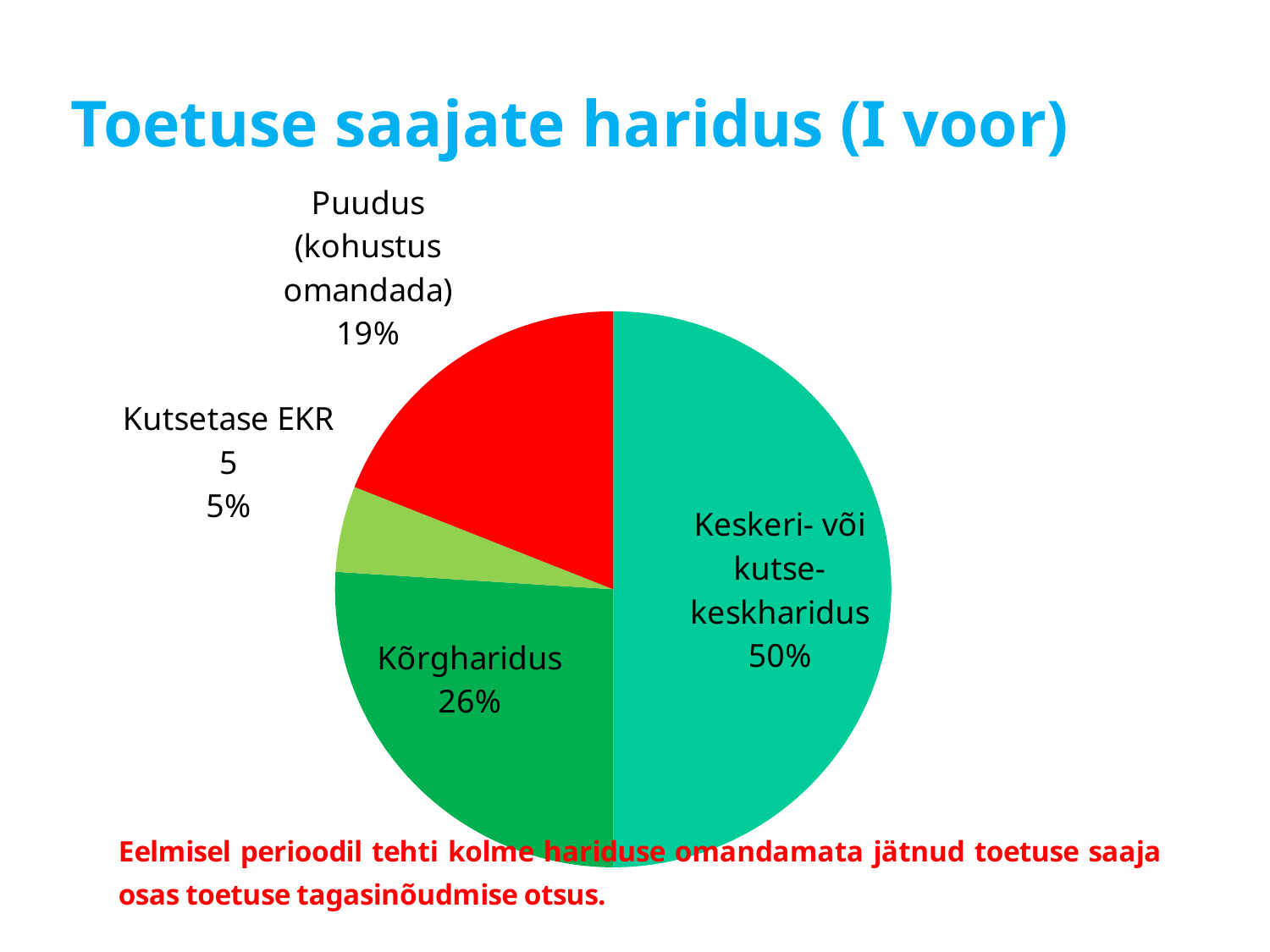
Which is larger, the share for Kõrgharidus or the share for Puudus (kohustus omandada)? Kõrgharidus What colour is the slice for Puudus (kohustus omandada)? Red Which category has the largest slice of the pie? Keskeri- või kutsekeskharidus What share of the pie does Kutsetase EKR 5 hold? 5% What kind of chart is shown on the slide? Pie chart How many categories are shown in the pie chart? 4 What share of the pie does Keskeri- või kutsekeskharidus hold? 50% Which category has the smallest slice of the pie? Kutsetase EKR 5 What is the title of the slide? Toetuse saajate haridus (I voor) What share of the pie does Puudus (kohustus omandada) hold? 19% What is the difference in percentage points between Kõrgharidus and Puudus (kohustus omandada)? 7